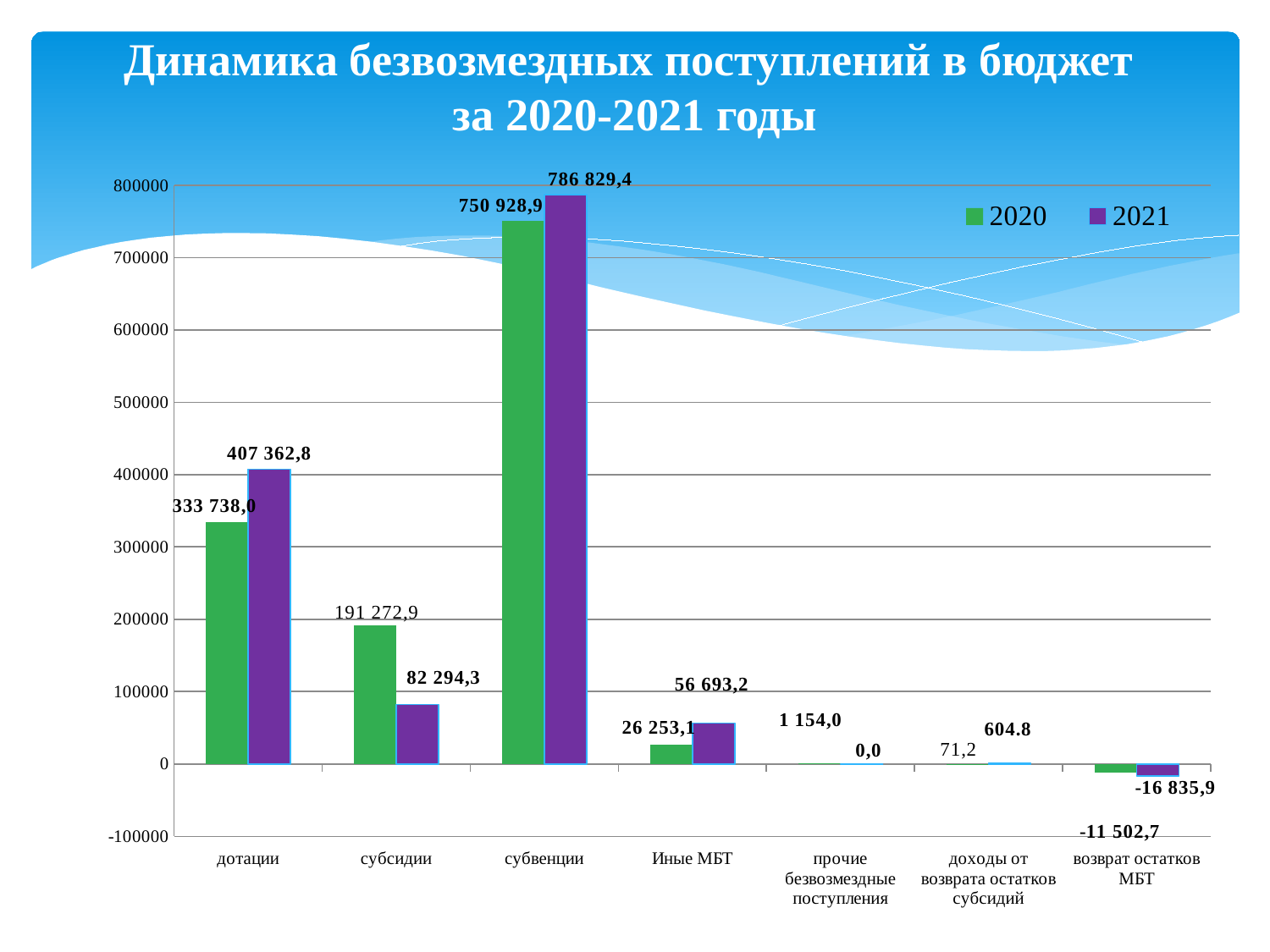
What is the difference between the 2021 and 2020 values for дотации? 73 624,8 How many categories are shown on the x axis? 7 How many series does the legend list? 2 What is the 2021 value for субвенции? 786 829,4 What is the difference between the 2020 and 2021 values for субсидии? 108 978,6 What type of chart is shown on the slide? bar chart Which category has the highest 2021 value? субвенции What is the 2020 value for субсидии? 191 272,9 Which is larger for Иные МБТ, the 2020 value or the 2021 value? 2021 Which category has the lowest 2020 value? возврат остатков МБТ What is the 2021 value for возврат остатков МБТ? -16 835,9 Which colour represents the 2021 series in the legend? purple